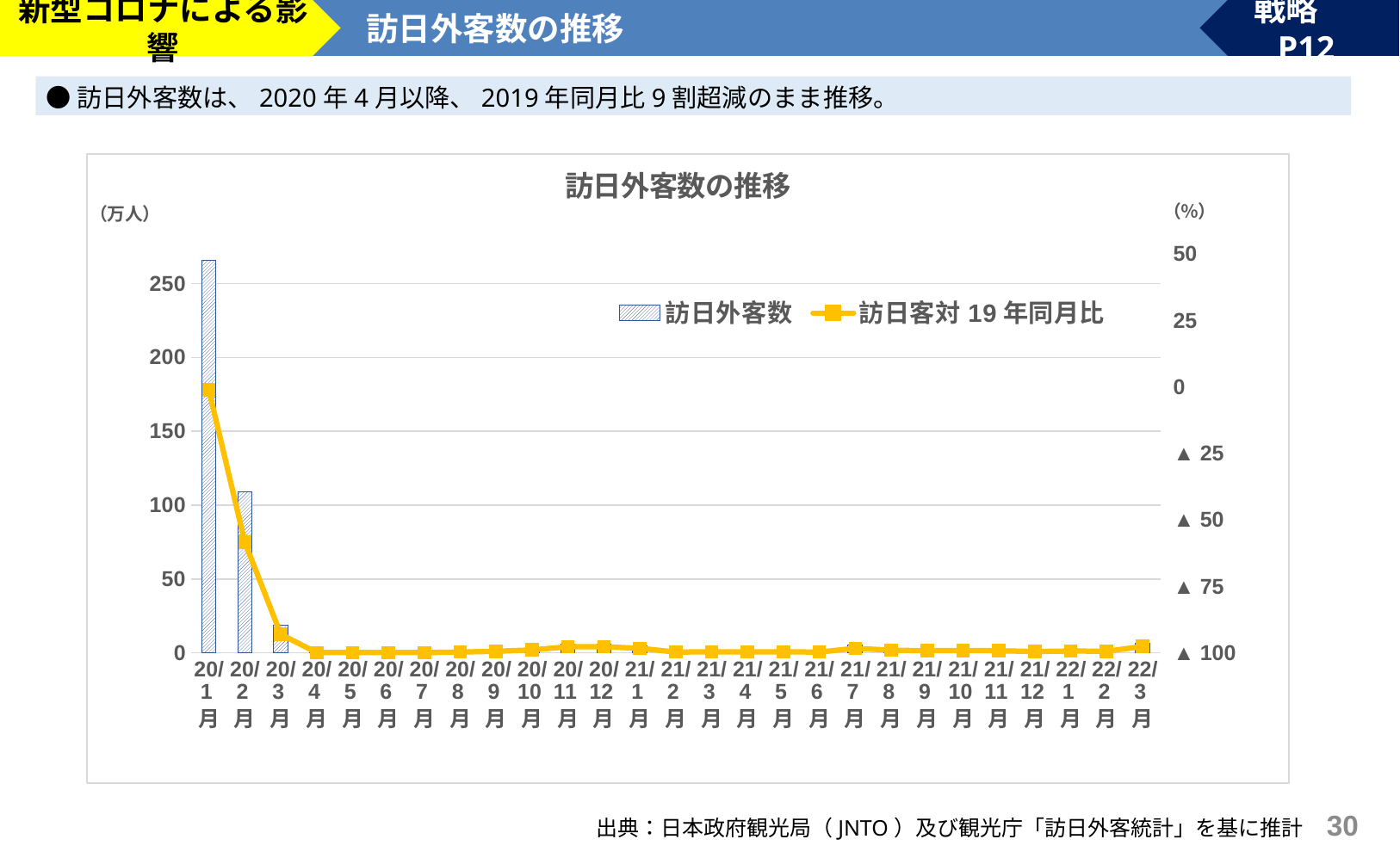
What kind of chart is shown on the slide? A combined bar and line chart How many months are shown along the x axis? 27 Is the 訪日外客数 bar for 20/2月 greater or less than 100? greater Which month has the highest bar for 訪日外客数? 20/1月 How many series does the legend list? 2 Is the 訪日外客数 bar for 20/1月 greater or less than 250? greater What is the title of the chart? 訪日外客数の推移 Is the 訪日外客数 bar for 20/3月 greater or less than 50? less Do the 訪日外客数 bars rise or fall from 20/1月 to 20/4月? fall What unit is shown on the left axis of the chart? 万人 Which is larger, the 訪日外客数 bar for 20/1月 or for 20/2月? 20/1月